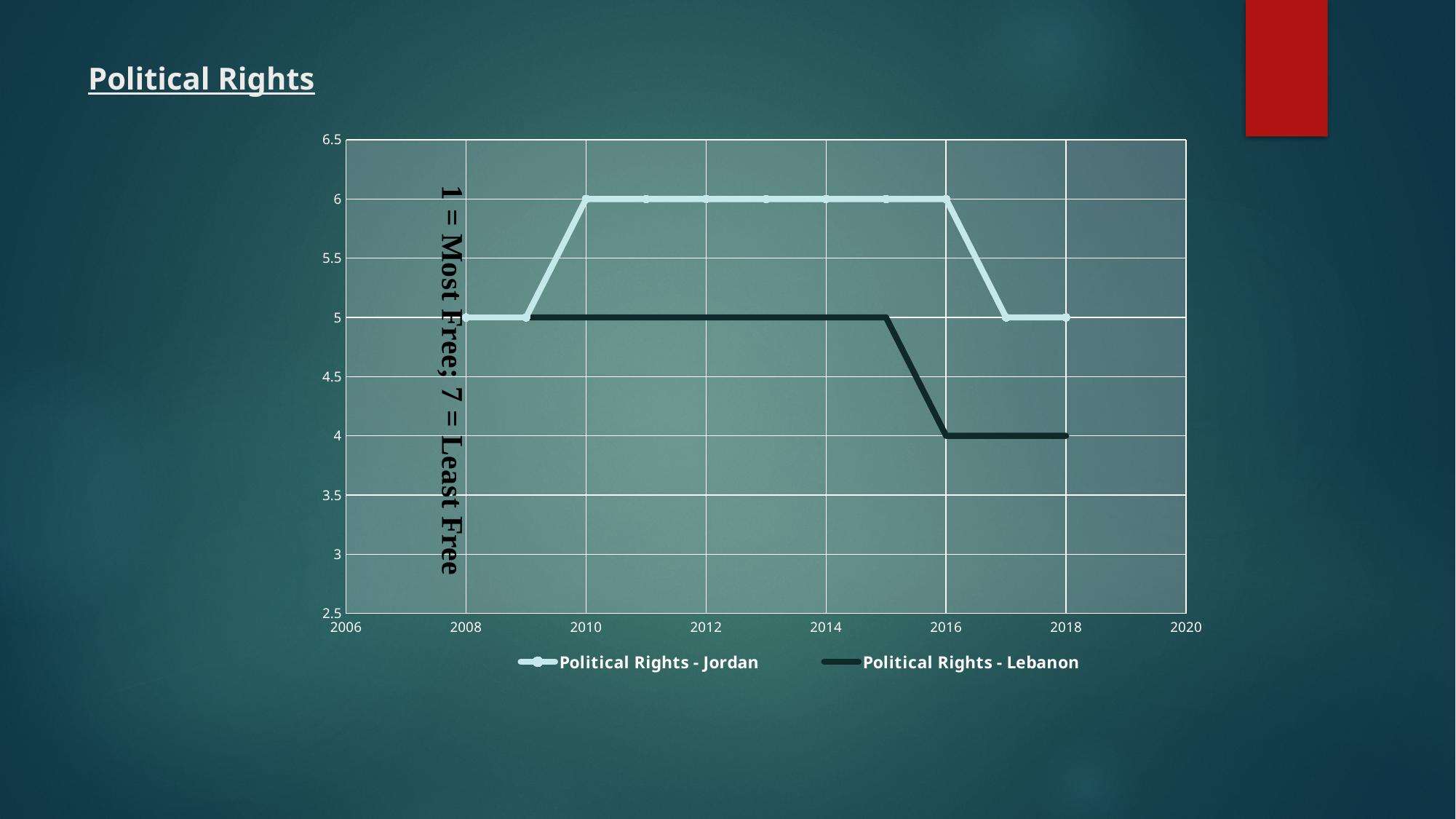
Which series has the higher value in 2016, Jordan or Lebanon? Political Rights - Jordan What is the Political Rights value for Jordan in 2008? 5 What is the difference between the Jordan and Lebanon values in 2017? 1 Does the Jordan line rise or fall between 2009 and 2010? rise What is the Political Rights value for Lebanon in 2018? 4 What is the Political Rights value for Jordan in 2012? 6 In which year does the Lebanon series first reach its lowest value? 2016 How many series does the legend list? 2 What is the title of the slide? Political Rights What is the Political Rights value for Lebanon in 2014? 5 What kind of chart is shown on the slide? line chart Does the Lebanon line rise or fall between 2015 and 2016? fall